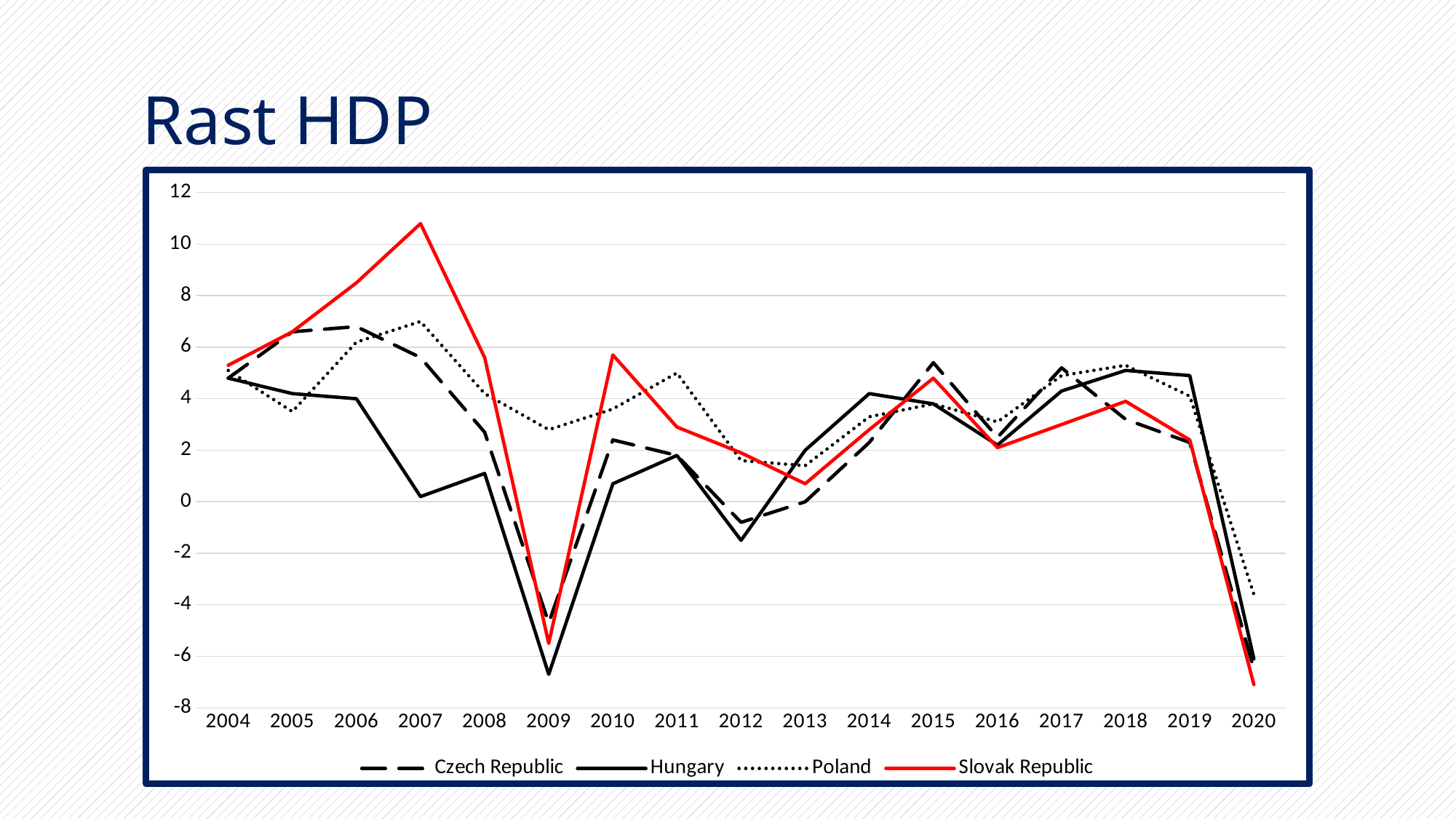
How many years are shown on the x axis? 17 What kind of chart is shown on the slide? line chart Is the value for Poland in 2020 greater or less than -2? less In 2012, which series has the higher value, Hungary or Poland? Poland Which series has the lowest value in 2009? Hungary Is the value for Slovak Republic in 2007 greater or less than 10? greater In 2020, which series has the higher value, Poland or Slovak Republic? Poland Which series has the highest value in 2007? Slovak Republic Does the Slovak Republic line rise or fall from 2004 to 2007? rise How many series does the legend list? 4 Is the value for Hungary in 2009 greater or less than -6? less